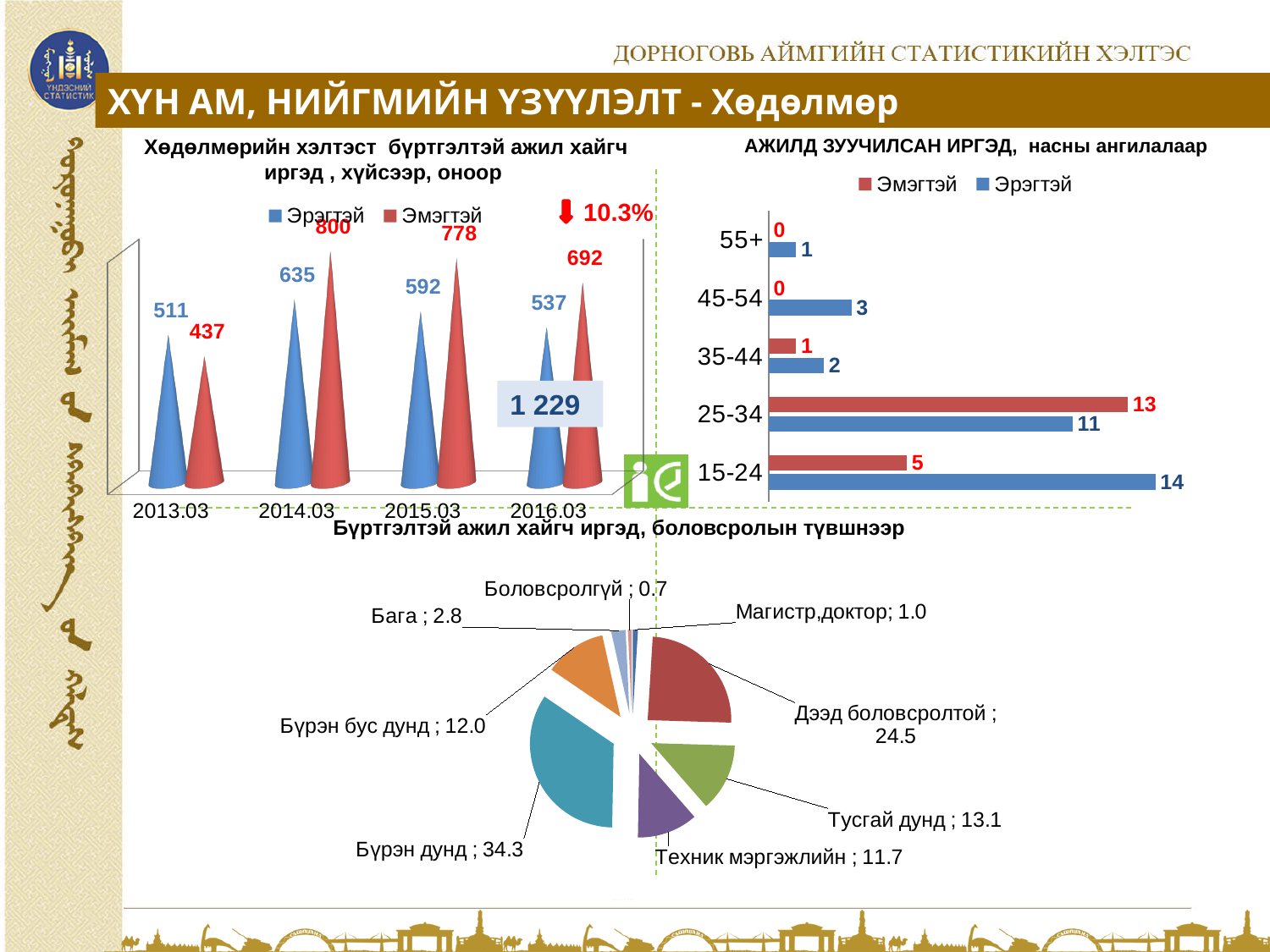
In the top-left chart (registered job seekers by sex), in which year is the Эрэгтэй value highest? 2014.03 In the top-left chart (registered job seekers by sex), how many series does the legend list? 2 In the top-right chart (АЖИЛД ЗУУЧИЛСАН ИРГЭД, насны ангилалаар), which is larger for the 25-34 group, Эмэгтэй or Эрэгтэй? Эмэгтэй In the bottom pie chart (Бүртгэлтэй ажил хайгч иргэд, боловсролын түвшнээр), which category has the smallest value? Боловсролгүй In the top-right chart (АЖИЛД ЗУУЧИЛСАН ИРГЭД, насны ангилалаар), what is the Эрэгтэй value for the 15-24 age group? 14 What kind of chart is the bottom chart (Бүртгэлтэй ажил хайгч иргэд, боловсролын түвшнээр)? pie chart In the top-left chart (registered job seekers by sex), what is the difference between Эмэгтэй and Эрэгтэй in 2016.03? 155 In the bottom pie chart (Бүртгэлтэй ажил хайгч иргэд, боловсролын түвшнээр), what is the value for Бүрэн дунд? 34.3 In the top-left chart (registered job seekers by sex), what is the value for Эрэгтэй in 2013.03? 511 In the top-left chart (registered job seekers by sex), what is the value for Эмэгтэй in 2014.03? 800 In the top-right chart (АЖИЛД ЗУУЧИЛСАН ИРГЭД, насны ангилалаар), which age group has the highest Эмэгтэй value? 25-34 In the top-right chart (АЖИЛД ЗУУЧИЛСАН ИРГЭД, насны ангилалаар), how many age groups are shown? 5